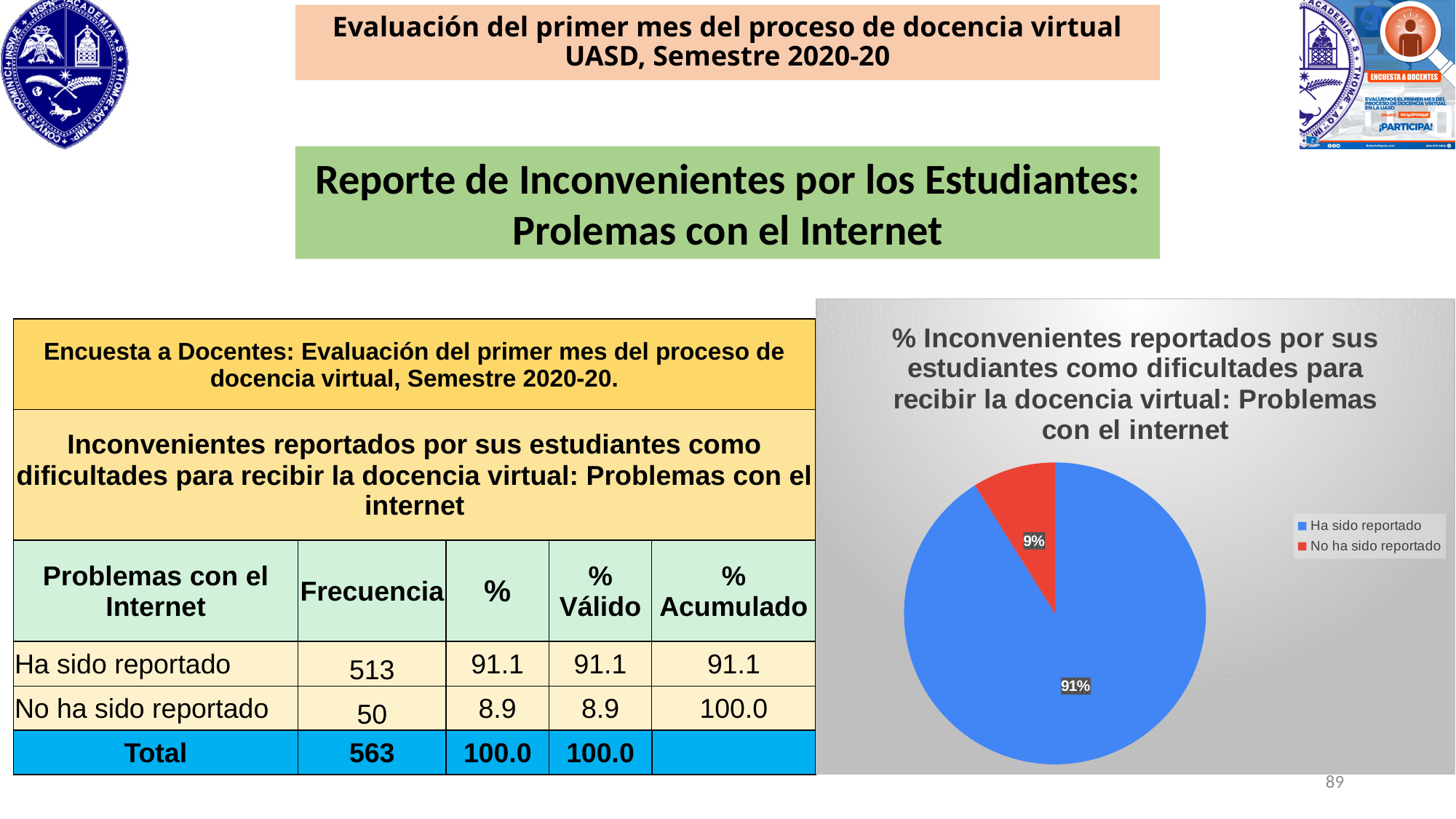
What colour is the "Ha sido reportado" slice in the pie chart? blue Which slice of the pie chart is the smallest? No ha sido reportado Which is larger in the pie chart, "Ha sido reportado" or "No ha sido reportado"? Ha sido reportado What colour is the "No ha sido reportado" slice in the pie chart? red What percentage does the pie chart show for "Ha sido reportado"? 91% What percentage does the pie chart show for "No ha sido reportado"? 9% What is the difference in percentage points between the "Ha sido reportado" and "No ha sido reportado" slices in the pie chart? 82% What kind of chart is shown on the slide? pie chart How many slices does the pie chart have? 2 How many entries does the pie chart legend list? 2 Which slice of the pie chart is the largest? Ha sido reportado